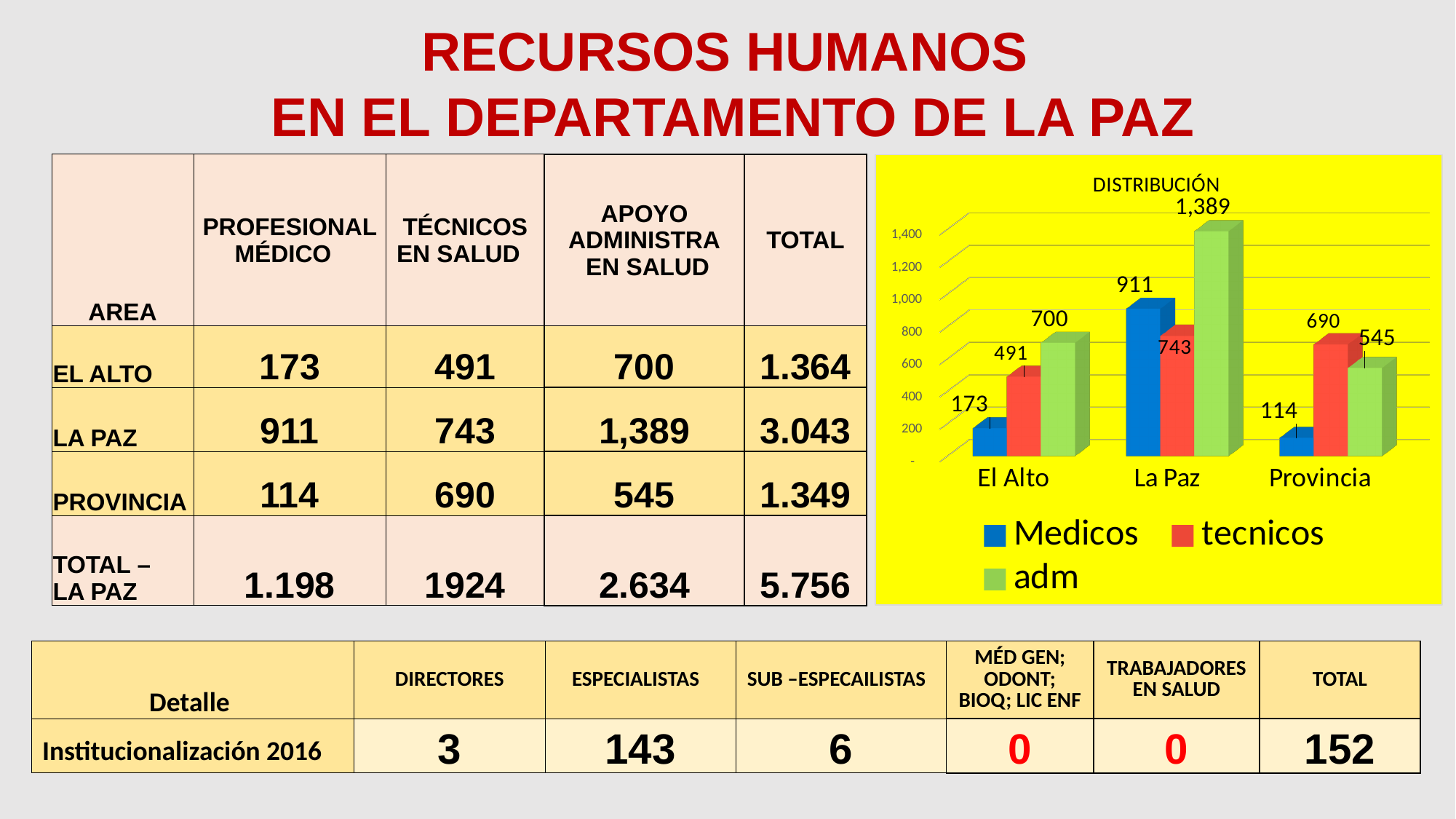
In the DISTRIBUCIÓN chart, what is the value for tecnicos in Provincia? 690 In the DISTRIBUCIÓN chart, which category has the lowest Medicos value? Provincia In the DISTRIBUCIÓN chart, which is larger: tecnicos in Provincia or adm in Provincia? tecnicos in Provincia What kind of chart is the DISTRIBUCIÓN chart? Bar chart How many categories are shown on the x axis of the DISTRIBUCIÓN chart? 3 In the DISTRIBUCIÓN chart, what is the difference between the Medicos values for La Paz and El Alto? 738 In the DISTRIBUCIÓN chart, what is the value for Medicos in La Paz? 911 In the DISTRIBUCIÓN chart, which category has the highest adm value? La Paz In the DISTRIBUCIÓN chart, what is the value for adm in El Alto? 700 In the DISTRIBUCIÓN chart, is the adm value for La Paz greater or less than 1,200? greater How many series does the legend of the DISTRIBUCIÓN chart list? 3 In the DISTRIBUCIÓN chart, which colour represents the tecnicos series? Red